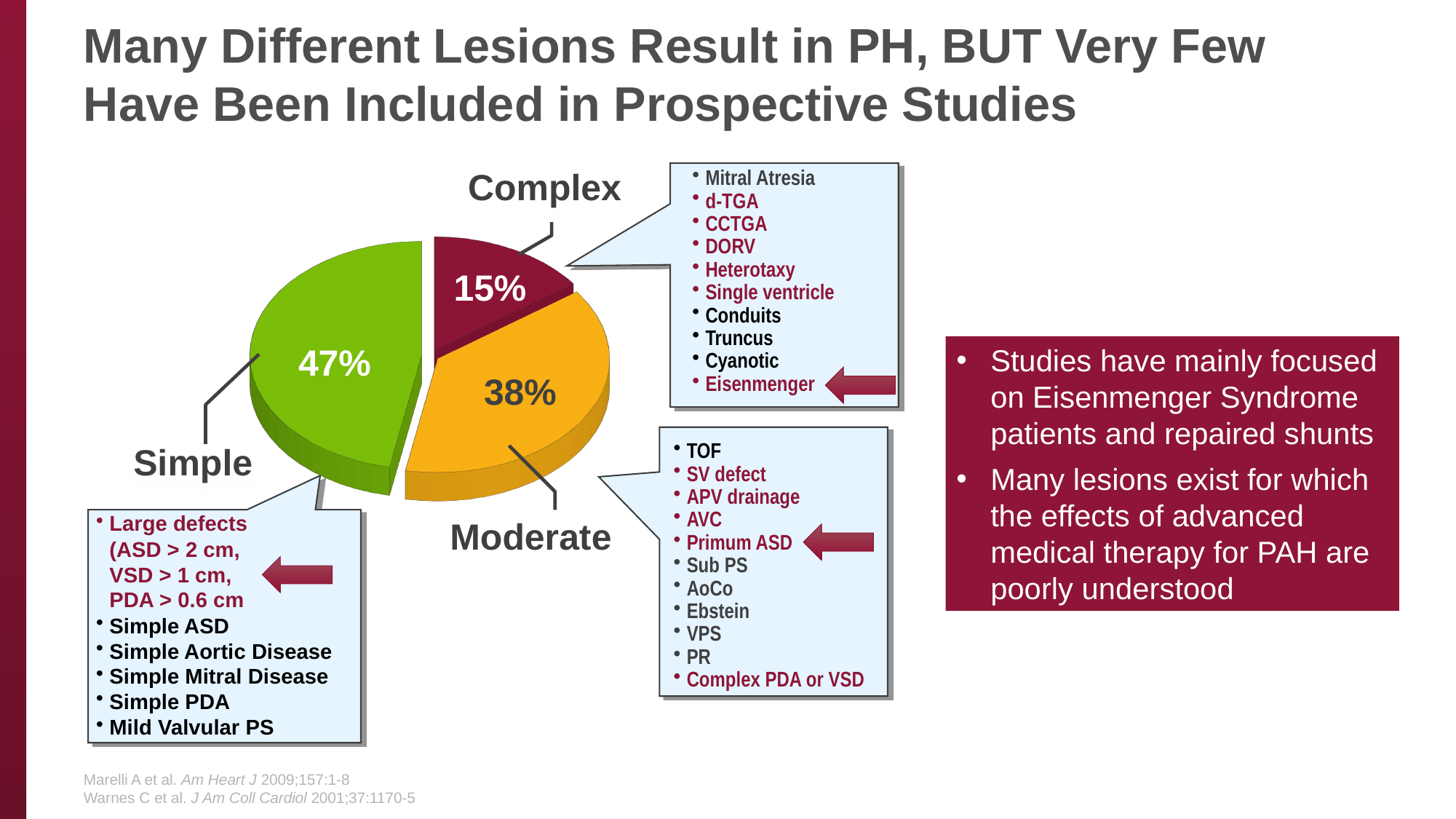
What colour is the Simple slice of the pie chart? Green Which category has the smallest slice of the pie chart? Complex Which category has the largest slice of the pie chart? Simple How many slices does the pie chart have? 3 Which slice is larger, Moderate or Complex? Moderate What percentage of the pie chart is labelled Complex? 15% What percentage of the pie chart is labelled Simple? 47% What percentage of the pie chart is labelled Moderate? 38% What is the difference in percentage points between the Moderate and Complex slices? 23 What is the difference in percentage points between the Simple and Complex slices? 32 What kind of chart is shown on the slide? Pie chart What colour is the Moderate slice of the pie chart? Orange